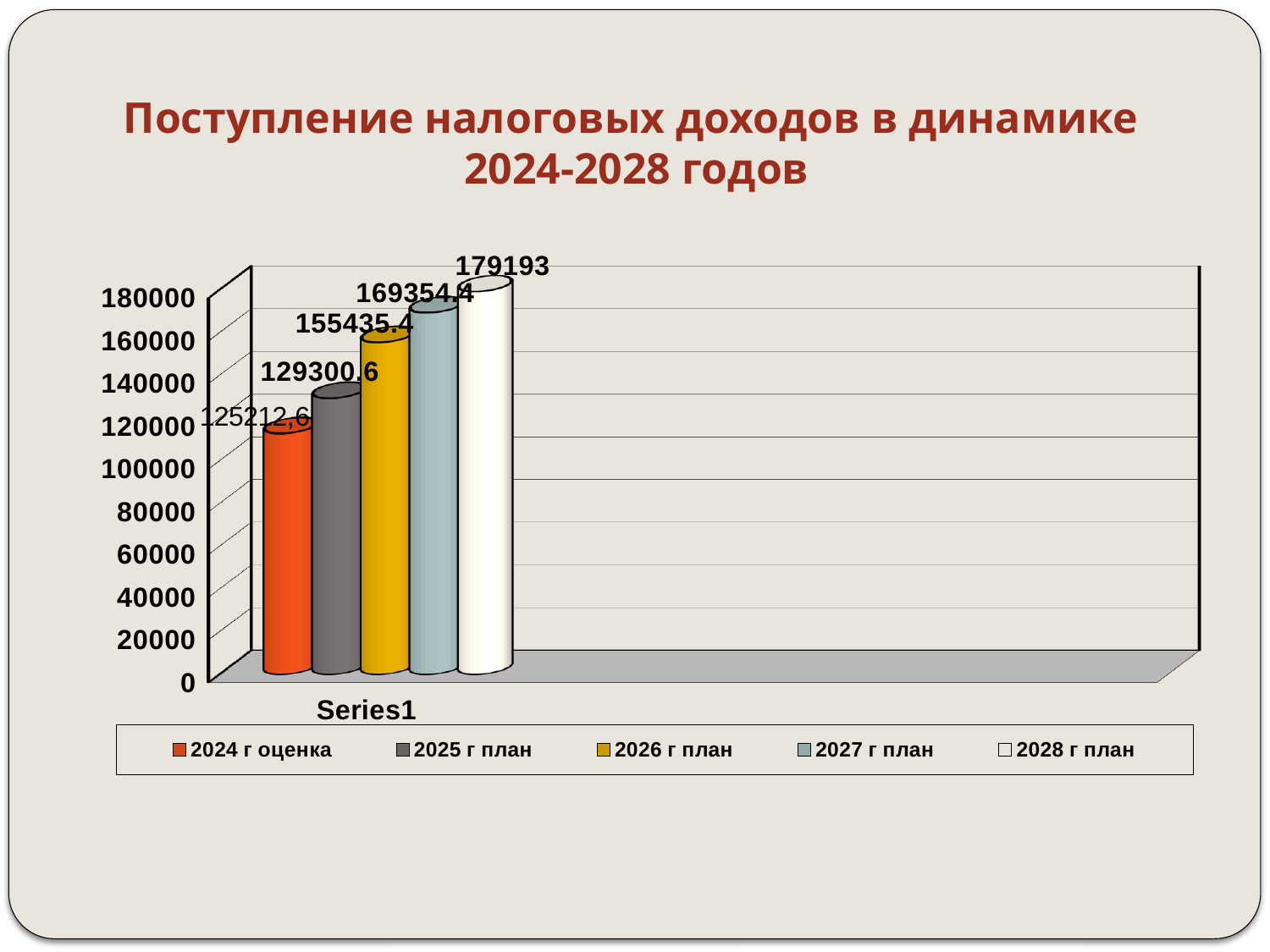
Which series has the lowest value? 2024 г оценка What is the value for 2028 г план? 179193 What is the value for 2025 г план? 129300.6 Which series has the highest value? 2028 г план Is the value for 2027 г план greater or less than 160000? greater What is the value for 2026 г план? 155435.4 What is the difference between the values for 2027 г план and 2026 г план? 13919 How many series does the legend list? 5 What kind of chart is shown on the slide? bar chart What is the value for 2024 г оценка? 125212,6 Which is larger, the value for 2026 г план or the value for 2025 г план? 2026 г план Do the values rise or fall from 2024 г оценка to 2028 г план? rise